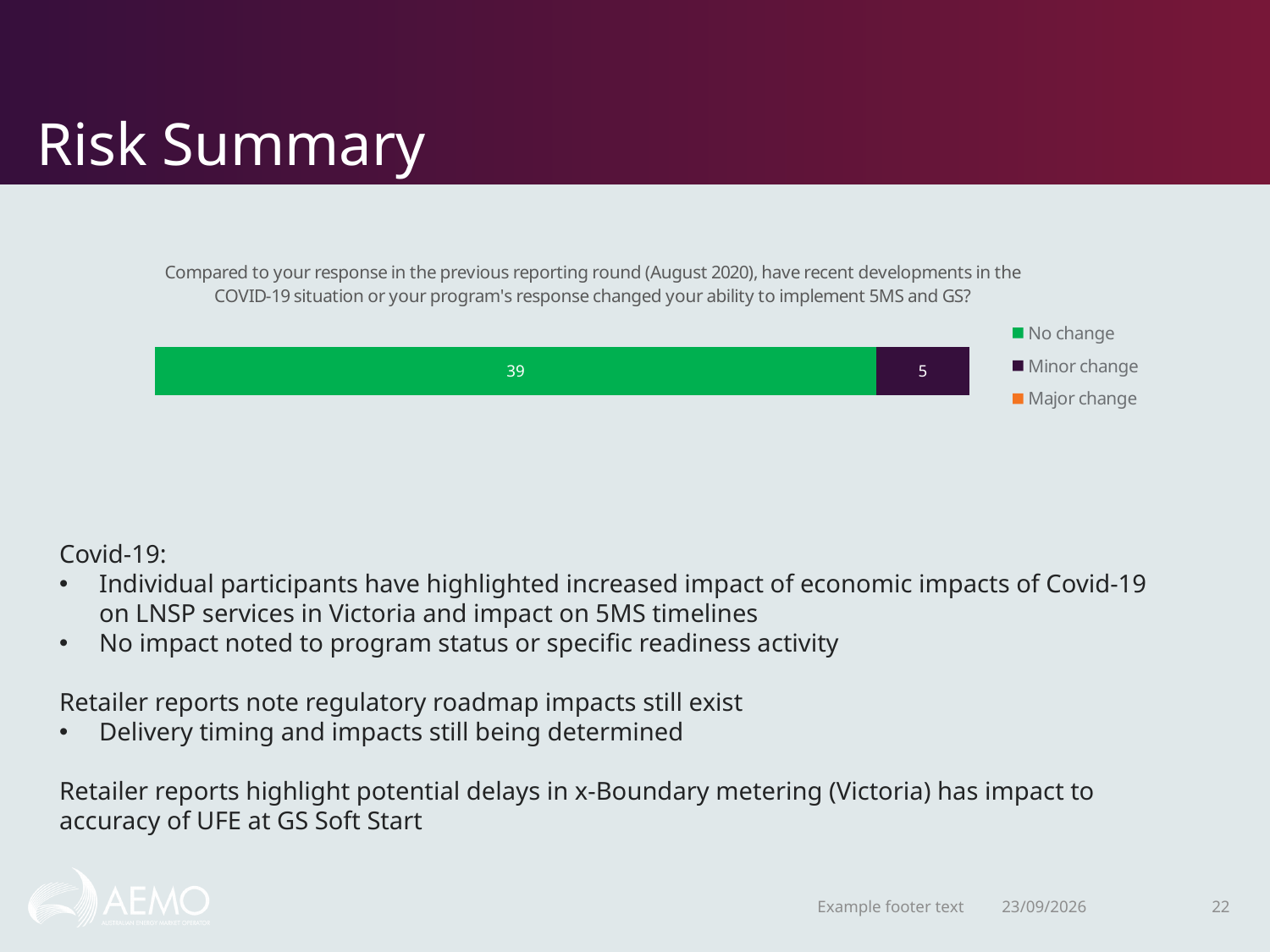
Which is larger, the "No change" value or the "Minor change" value? No change What value is shown for "No change" in the chart? 39 Which legend entry has the largest value in the chart? No change Which legend entry is shown in orange? Major change What kind of chart is shown on the slide? Stacked bar chart What is the total of the labelled segments in the stacked bar? 44 What colour is the "No change" segment in the chart? Green Which legend entry has no visible segment in the bar? Major change How many series does the chart legend list? 3 What is the difference between the "No change" and "Minor change" values? 34 What value is shown for "Minor change" in the chart? 5